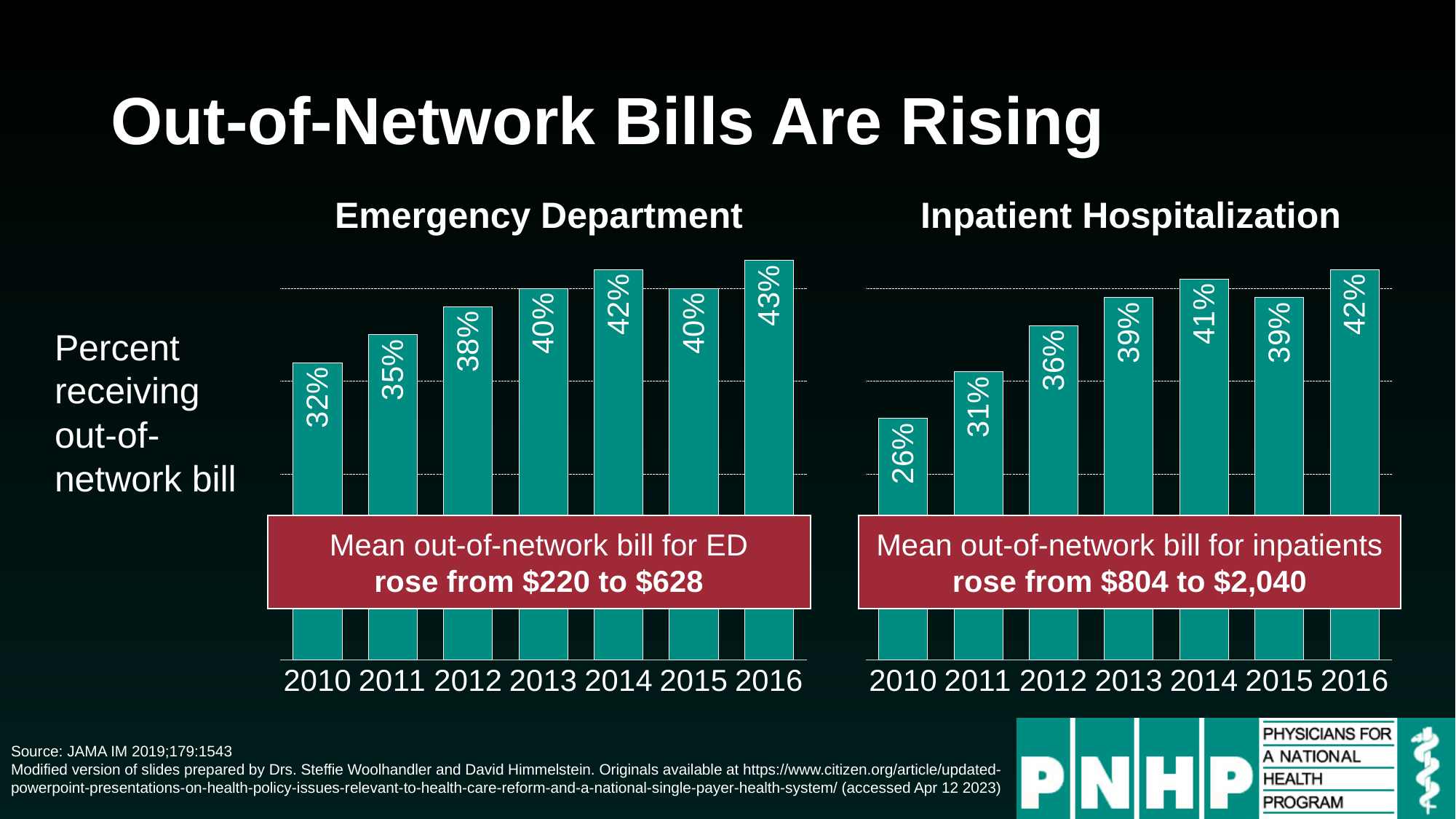
In the Emergency Department chart, what is the difference in percentage points between 2016 and 2010? 11 In the Inpatient Hospitalization chart, what is the difference in percentage points between 2016 and 2010? 16 In the Inpatient Hospitalization chart, what percent received an out-of-network bill in 2014? 41% In the Inpatient Hospitalization chart, which year has the larger value, 2012 or 2015? 2015 According to the Emergency Department chart's annotation, what did the mean out-of-network bill for ED rise to? $628 What type of chart is the Inpatient Hospitalization chart? Bar chart How many years are shown in the Emergency Department chart? 7 In the Emergency Department chart, what percent received an out-of-network bill in 2010? 32% According to the Inpatient Hospitalization chart's annotation, what did the mean out-of-network bill for inpatients rise from? $804 In the Emergency Department chart, which year has the highest percent receiving an out-of-network bill? 2016 In the Inpatient Hospitalization chart, do the values generally rise or fall from 2010 to 2016? Rise In the Inpatient Hospitalization chart, which year has the lowest percent receiving an out-of-network bill? 2010